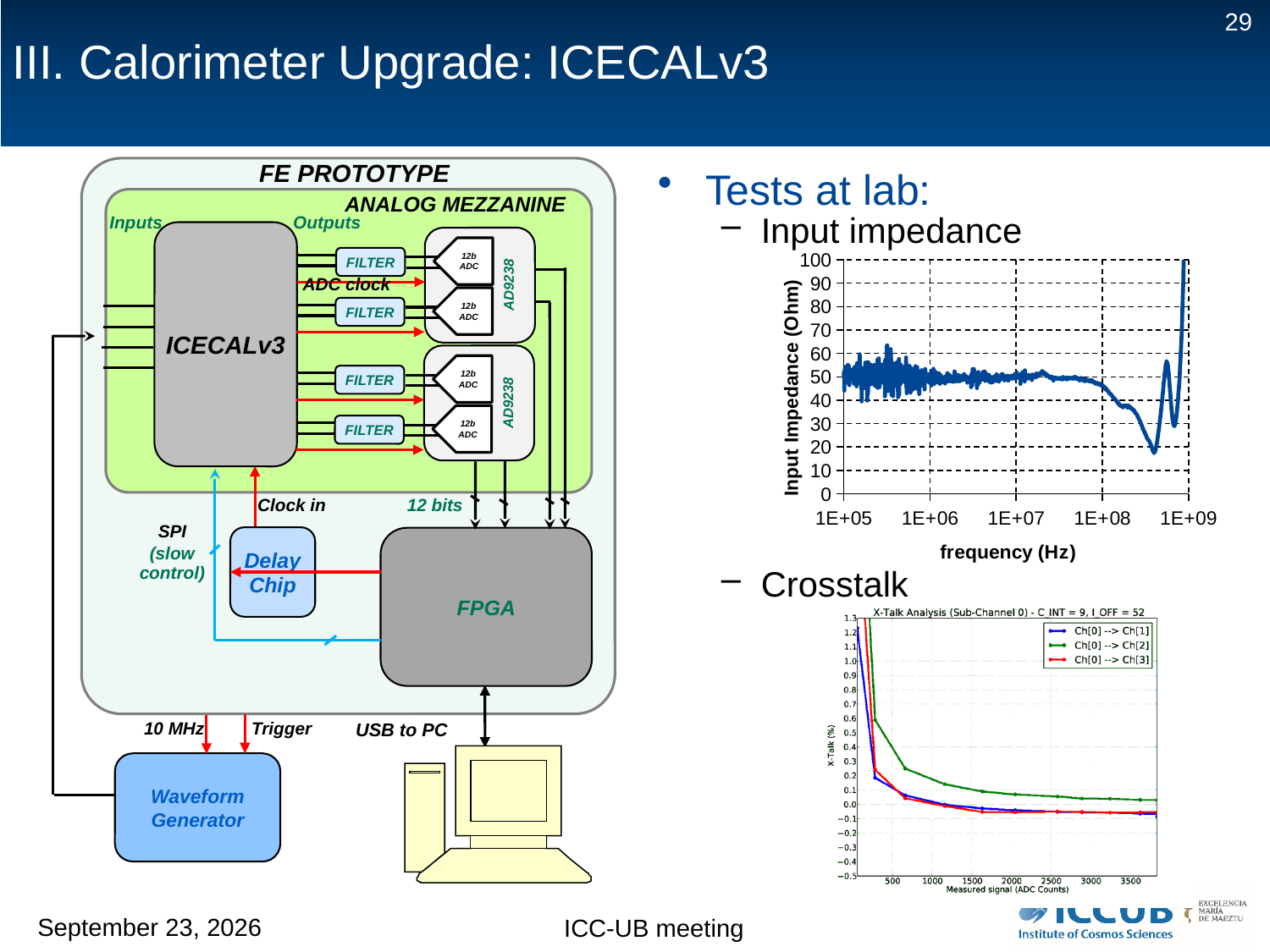
In the Input impedance chart, is the input impedance at a frequency of 1E+07 Hz greater or less than 70? less In the Input impedance chart, does the input impedance rise or fall as frequency increases from 1E+08 Hz to about 4E+08 Hz? fall In the Input impedance chart, what is the label of the y axis? Input Impedance (Ohm) What kind of chart is the Input impedance chart? line chart In the Input impedance chart, what is the label of the x axis? frequency (Hz) In the Crosstalk chart, which series has the highest X-Talk value at a measured signal of 3500 ADC counts? Ch[0] --> Ch[2] In the Crosstalk chart, is the X-Talk value for Ch[0] --> Ch[2] at a measured signal of 3500 ADC counts greater or less than 0.5? less In the Crosstalk chart, does the X-Talk value rise or fall as the measured signal increases? fall In the Input impedance chart, is the input impedance at a frequency of 1E+06 Hz greater or less than 40? greater What kind of chart is the Crosstalk chart? line chart How many series does the legend of the Crosstalk chart list? 3 In the Crosstalk chart, which series is larger at a measured signal of 2000 ADC counts, Ch[0] --> Ch[2] or Ch[0] --> Ch[3]? Ch[0] --> Ch[2]